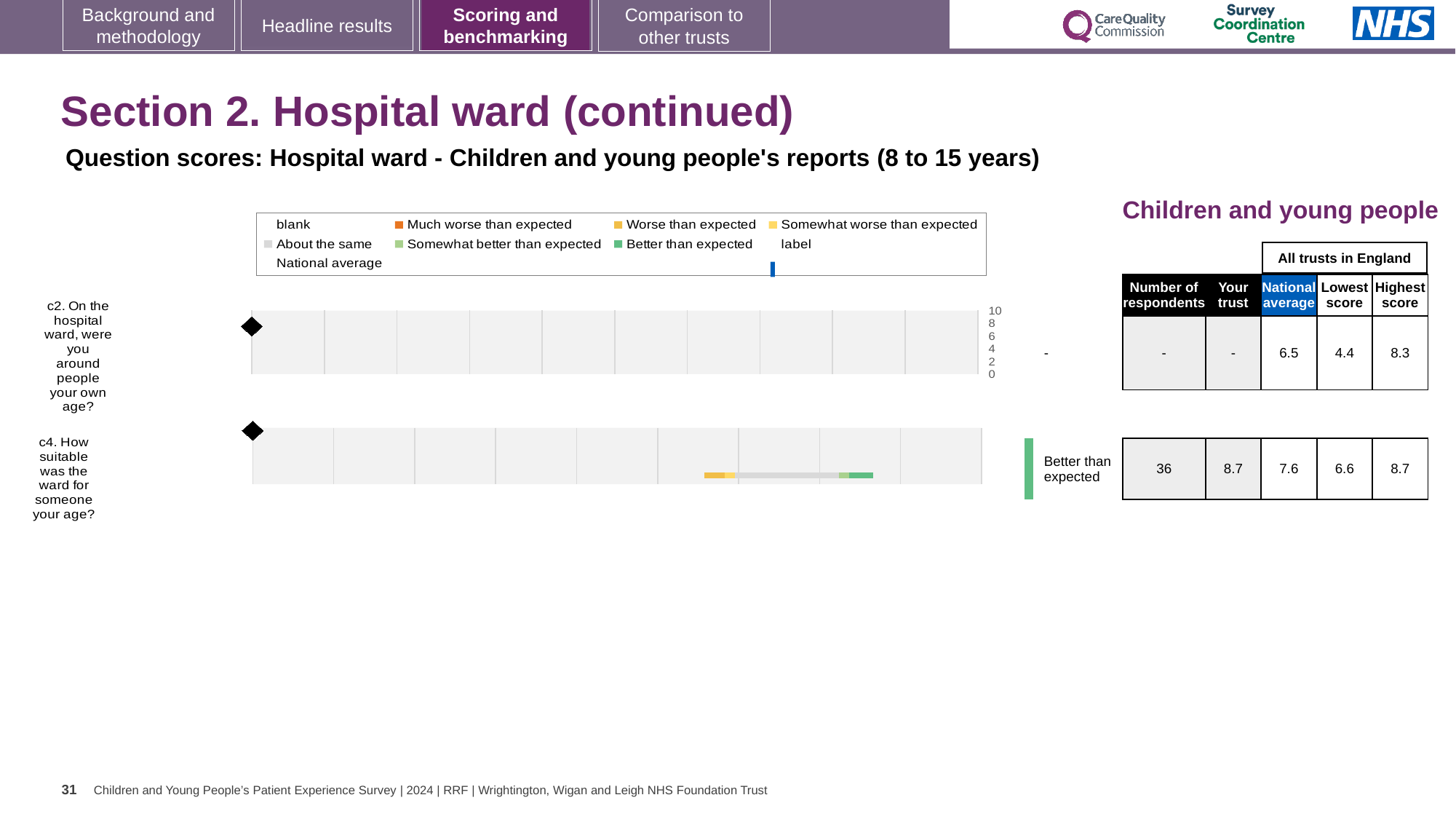
What is the national average score for question c4? 7.6 How many survey questions are plotted in the chart? 2 What benchmark category is shown for question c4? Better than expected What kind of chart is used to show the question scores on this slide? bar chart Which question has the higher national average, c2 or c4? c4 What is the trust's score for question c4 (How suitable was the ward for someone your age?)? 8.7 By how much does the trust's score for c4 exceed the national average for c4? 1.1 What is the national average score for question c2? 6.5 What is the lowest score among all trusts in England for question c2? 4.4 What is the difference between the highest and lowest scores for question c4? 2.1 What is the highest score among all trusts in England for question c2? 8.3 How many respondents answered question c4? 36